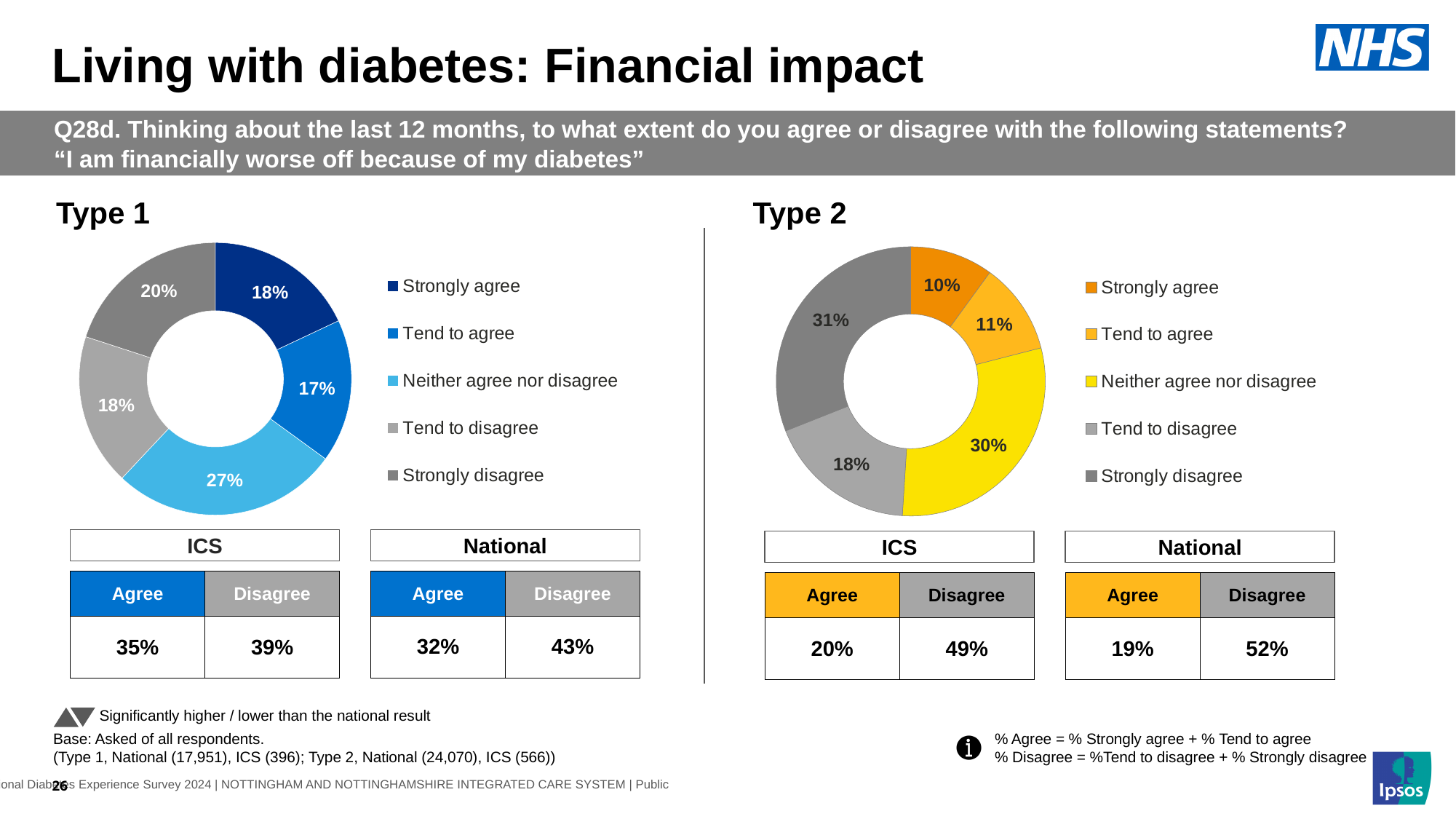
In the Type 1 chart, what percentage of respondents said 'Strongly agree'? 18% In the Type 2 chart, what percentage of respondents said 'Tend to agree'? 11% In the Type 1 chart, what percentage of respondents said 'Neither agree nor disagree'? 27% In the Type 1 chart, what is the difference between the 'Neither agree nor disagree' share and the 'Tend to agree' share? 10 percentage points How many response categories does the legend of the Type 2 chart list? 5 In the Type 2 chart, which response category has the smallest share? Strongly agree In the Type 2 chart, what percentage of respondents said 'Strongly disagree'? 31% In the Type 2 chart, what is the difference between the 'Strongly disagree' share and the 'Tend to disagree' share? 13 percentage points What type of chart is used for the Type 1 data? Donut (pie) chart In the Type 1 chart, which response category has the largest share? Neither agree nor disagree In the Type 2 chart, which response category has the largest share? Strongly disagree Which is larger: the 'Strongly agree' share in the Type 1 chart or the 'Strongly agree' share in the Type 2 chart? Type 1